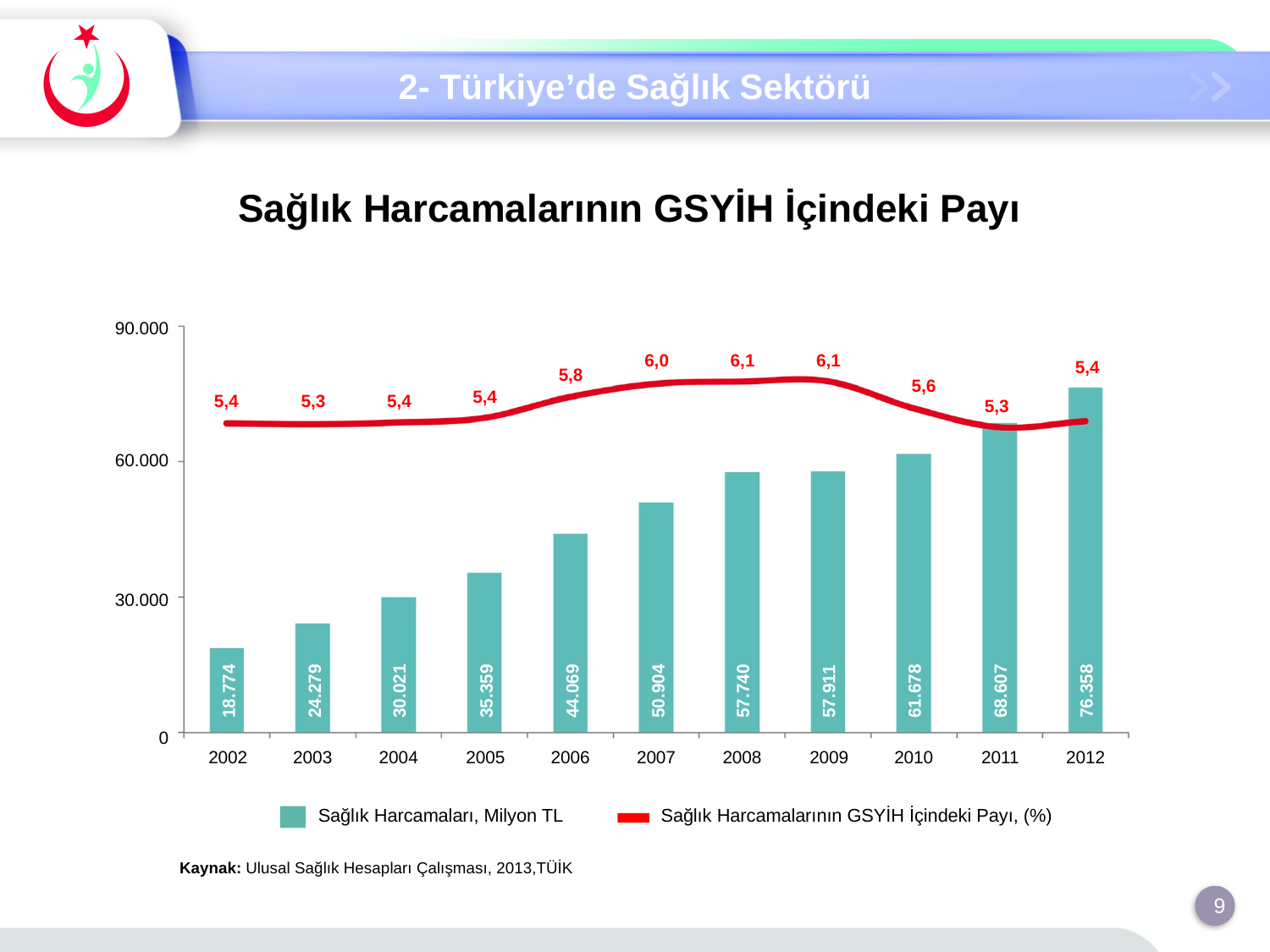
How many series does the legend list? 2 Which year has the highest value of Sağlık Harcamaları, Milyon TL? 2012 What is the value of Sağlık Harcamalarının GSYİH İçindeki Payı, (%) for 2007? 6,0 Which year has the lowest value of Sağlık Harcamaları, Milyon TL? 2002 Do the values of Sağlık Harcamaları, Milyon TL rise or fall from 2002 to 2012? rise What is the difference in Sağlık Harcamaları, Milyon TL between 2012 and 2011? 7.751 Is the value of Sağlık Harcamaları, Milyon TL for 2010 greater or less than 60.000? greater Which is larger, the Sağlık Harcamaları, Milyon TL value for 2006 or for 2007? 2007 What is the title of the chart? Sağlık Harcamalarının GSYİH İçindeki Payı What kind of chart is used for the Sağlık Harcamaları, Milyon TL series? bar chart How many years are shown on the x axis? 11 What is the value of Sağlık Harcamaları, Milyon TL for 2008? 57.740